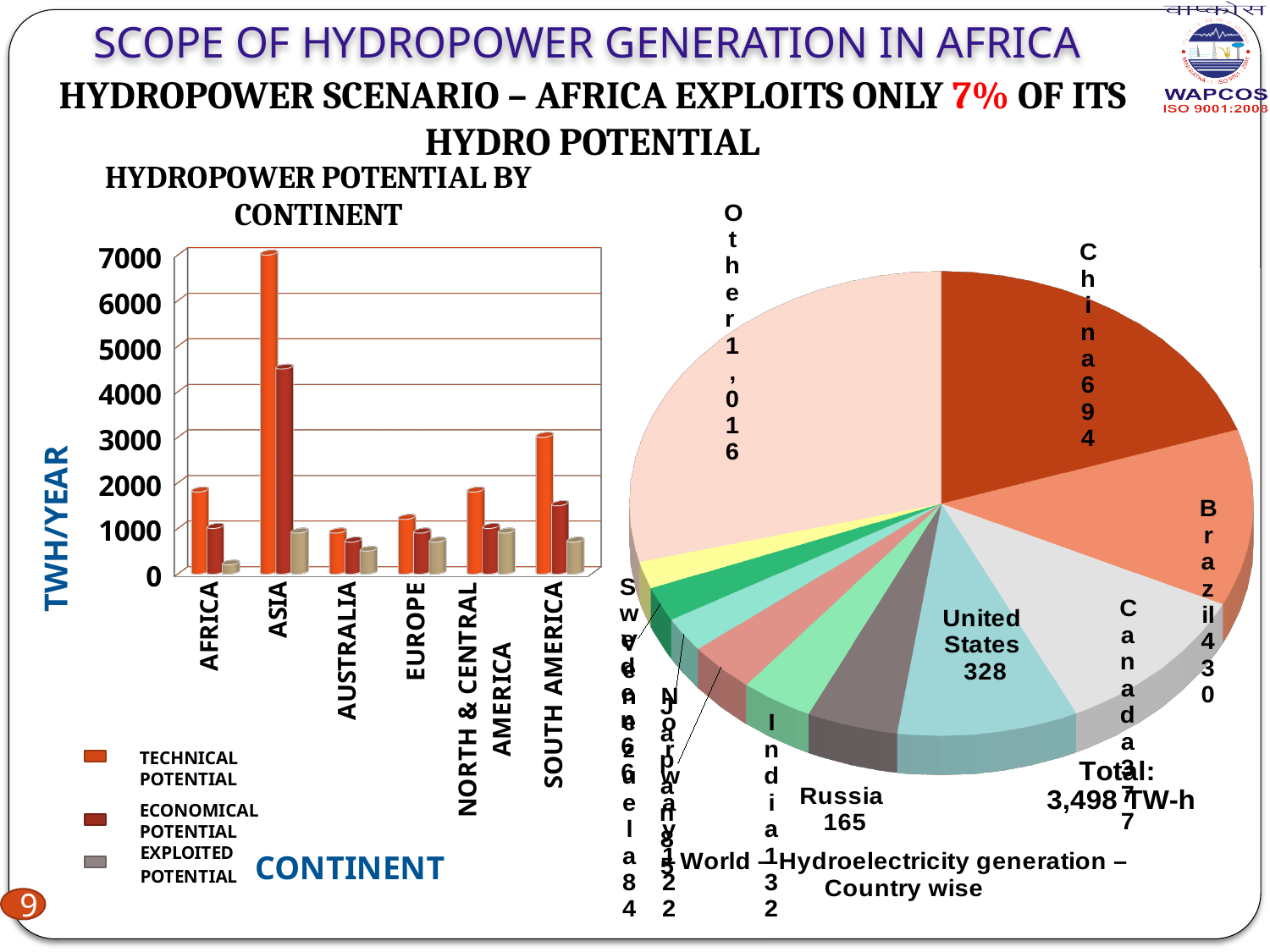
In the 'HYDROPOWER POTENTIAL BY CONTINENT' chart, how many series does the legend list? 3 In the 'HYDROPOWER POTENTIAL BY CONTINENT' chart, which continent has the highest technical potential? Asia In the 'HYDROPOWER POTENTIAL BY CONTINENT' chart, is the technical potential for Asia greater or less than 6000? greater In the 'World – Hydroelectricity generation – Country wise' pie chart, what is the value for China? 694 In the 'World – Hydroelectricity generation – Country wise' pie chart, which is larger, Russia or India? Russia In the 'HYDROPOWER POTENTIAL BY CONTINENT' chart, which has the larger technical potential, Asia or Europe? Asia What kind of chart is the 'HYDROPOWER POTENTIAL BY CONTINENT' chart on the left? Bar chart In the 'World – Hydroelectricity generation – Country wise' pie chart, what total is shown? 3,498 TW-h In the 'HYDROPOWER POTENTIAL BY CONTINENT' chart, is the exploited potential for Africa greater or less than 1000? less In the 'World – Hydroelectricity generation – Country wise' pie chart, what is the difference between the values for China and Brazil? 264 In the 'HYDROPOWER POTENTIAL BY CONTINENT' chart, how many continents are shown on the x axis? 6 In the 'HYDROPOWER POTENTIAL BY CONTINENT' chart, what is the label on the y axis? TWH/YEAR